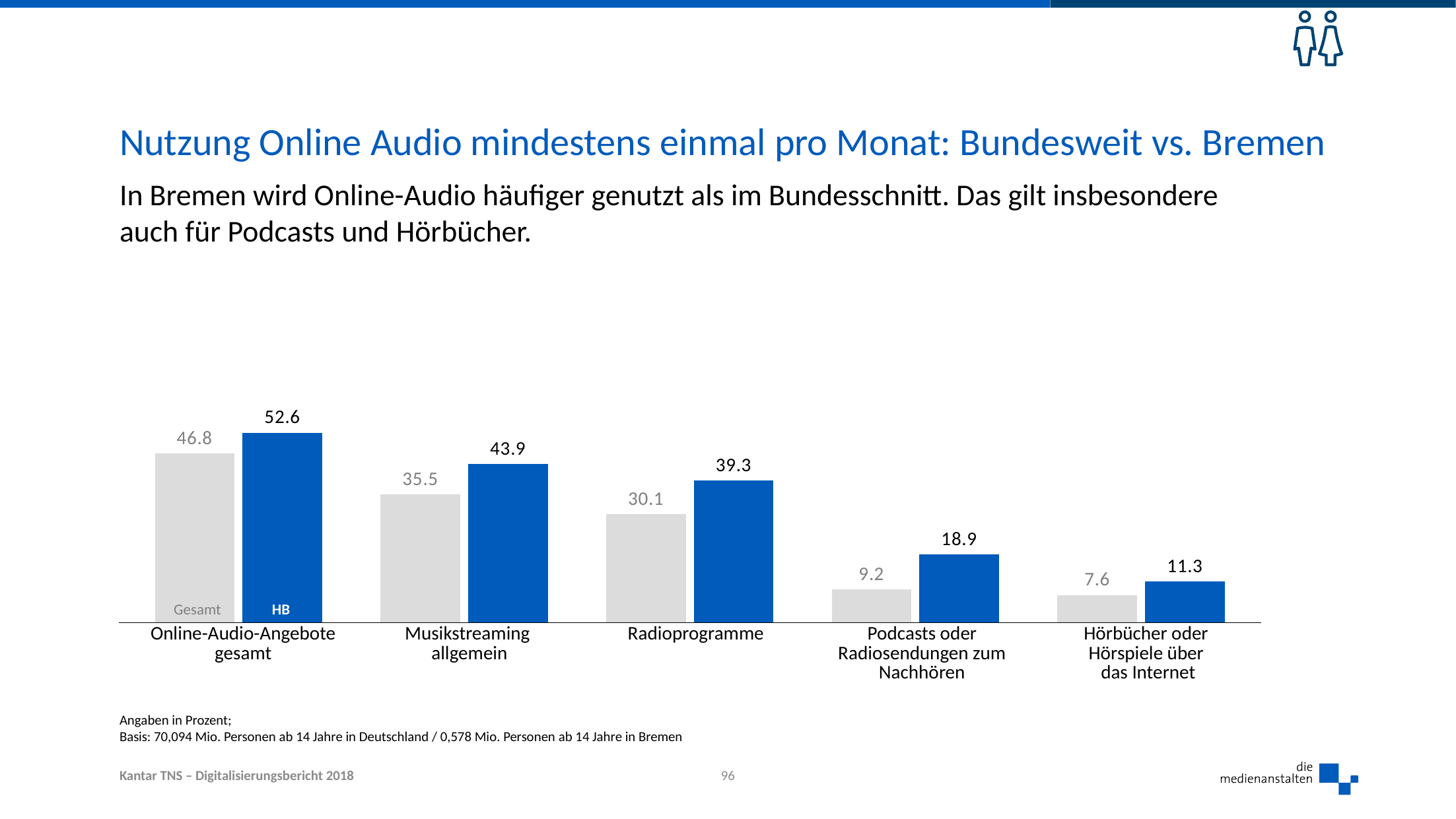
What is the difference between the HB and Gesamt values for Podcasts oder Radiosendungen zum Nachhören? 9.7 How many categories are shown on the x axis? 5 What is the Gesamt value for Podcasts oder Radiosendungen zum Nachhören? 9.2 What is the difference between the HB and Gesamt values for Online-Audio-Angebote gesamt? 5.8 What kind of chart is shown on the slide? Bar chart Which category has the highest HB value? Online-Audio-Angebote gesamt How many series does the chart show? 2 Which category has the lowest Gesamt value? Hörbücher oder Hörspiele über das Internet Which is larger for Radioprogramme, the Gesamt value or the HB value? HB What is the HB value for Hörbücher oder Hörspiele über das Internet? 11.3 What is the HB value for Musikstreaming allgemein? 43.9 What is the Gesamt value for Radioprogramme? 30.1